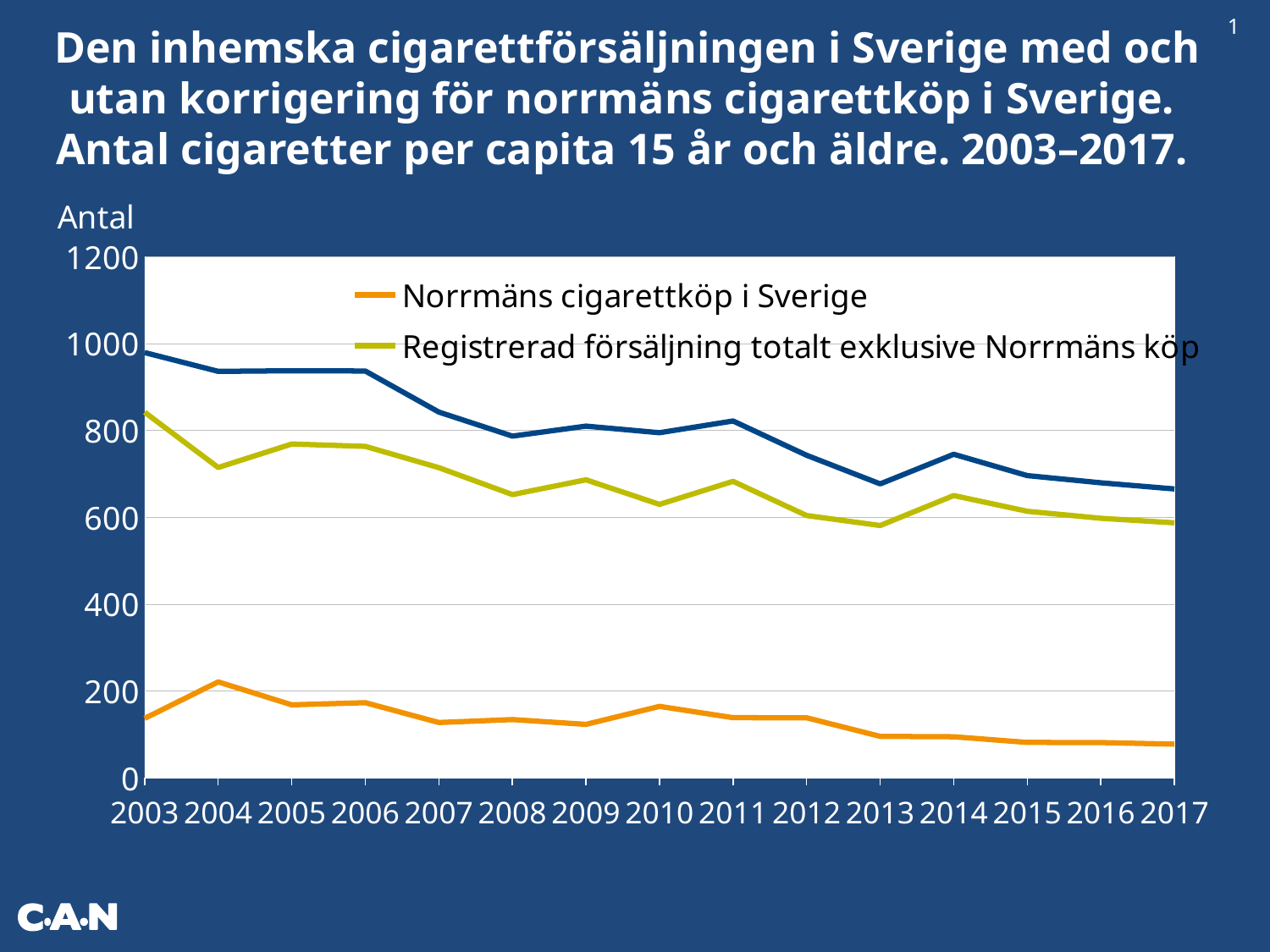
Is the value for Registrerad försäljning totalt exklusive Norrmäns köp in 2004 greater or less than 800? less In which year is Registrerad försäljning totalt exklusive Norrmäns köp at its highest? 2003 Is the value for Registrerad försäljning totalt exklusive Norrmäns köp in 2003 greater or less than 800? greater Does Registrerad försäljning totalt exklusive Norrmäns köp generally rise or fall from 2003 to 2017? Fall How many years are plotted along the x axis? 15 How many series does the legend list? 2 Is the value for Norrmäns cigarettköp i Sverige in 2017 greater or less than 200? less In which year is Norrmäns cigarettköp i Sverige at its highest? 2004 What kind of chart is shown on the slide? Line chart What is the label on the vertical axis? Antal Which year is the first on the x axis? 2003